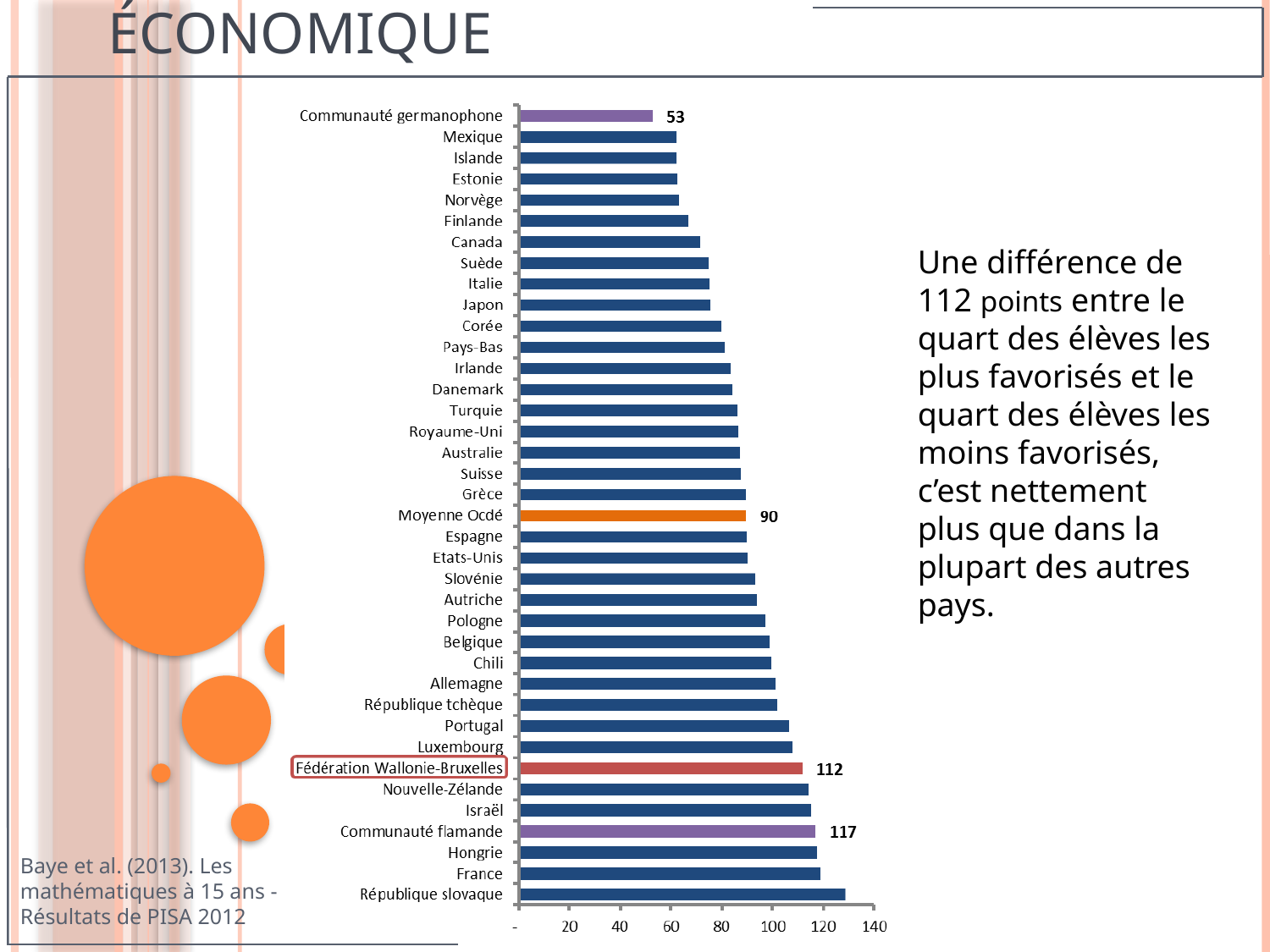
What is the difference between the values for Communauté flamande and Fédération Wallonie-Bruxelles? 5 Is the value for République slovaque greater or less than 120? greater Is the value for Mexique greater or less than 80? less Which category has the shortest bar? Communauté germanophone What is the value for Communauté germanophone? 53 What is the value for Moyenne Ocdé? 90 What is the value for Fédération Wallonie-Bruxelles? 112 What is the value for Communauté flamande? 117 What is the difference between the values for Fédération Wallonie-Bruxelles and Moyenne Ocdé? 22 Which is larger, the value for Fédération Wallonie-Bruxelles or the value for Moyenne Ocdé? Fédération Wallonie-Bruxelles What kind of chart is shown on the slide? bar chart Which category has the longest bar? République slovaque